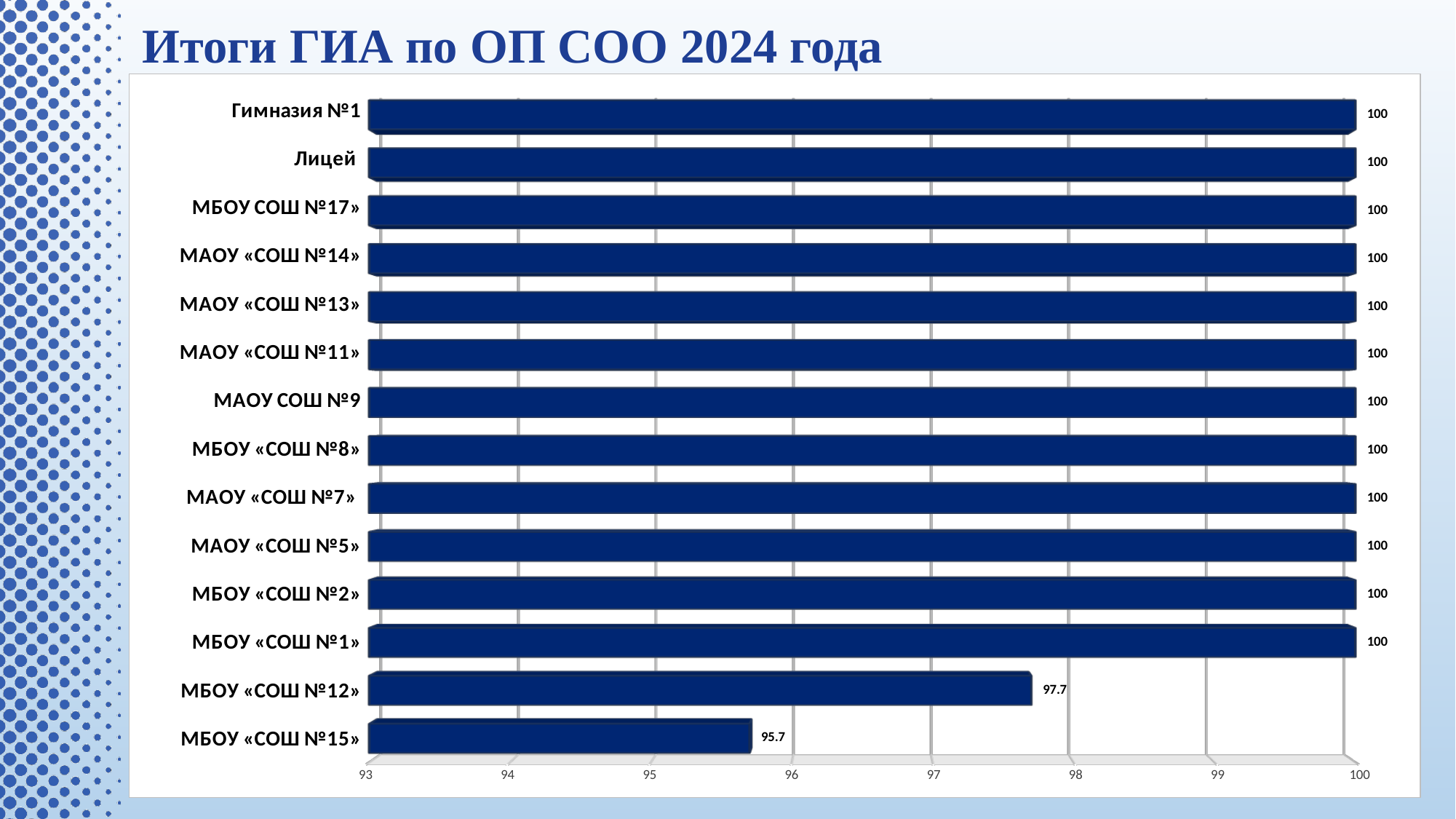
What is the title of the slide? Итоги ГИА по ОП СОО 2024 года Is the value for МБОУ «СОШ №15» greater or less than 96? less What kind of chart is shown on the slide? bar chart What is the difference between the values for Лицей and МБОУ «СОШ №12»? 2.3 Which category has the lowest value? МБОУ «СОШ №15» What is the value for МБОУ «СОШ №12»? 97.7 Which is larger, the value for МБОУ «СОШ №12» or the value for МБОУ «СОШ №15»? МБОУ «СОШ №12» What is the value for МБОУ «СОШ №15»? 95.7 What is the value for МАОУ «СОШ №13»? 100 What is the value for Гимназия №1? 100 How many categories are shown in the chart? 14 What is the difference between the values for МБОУ «СОШ №12» and МБОУ «СОШ №15»? 2